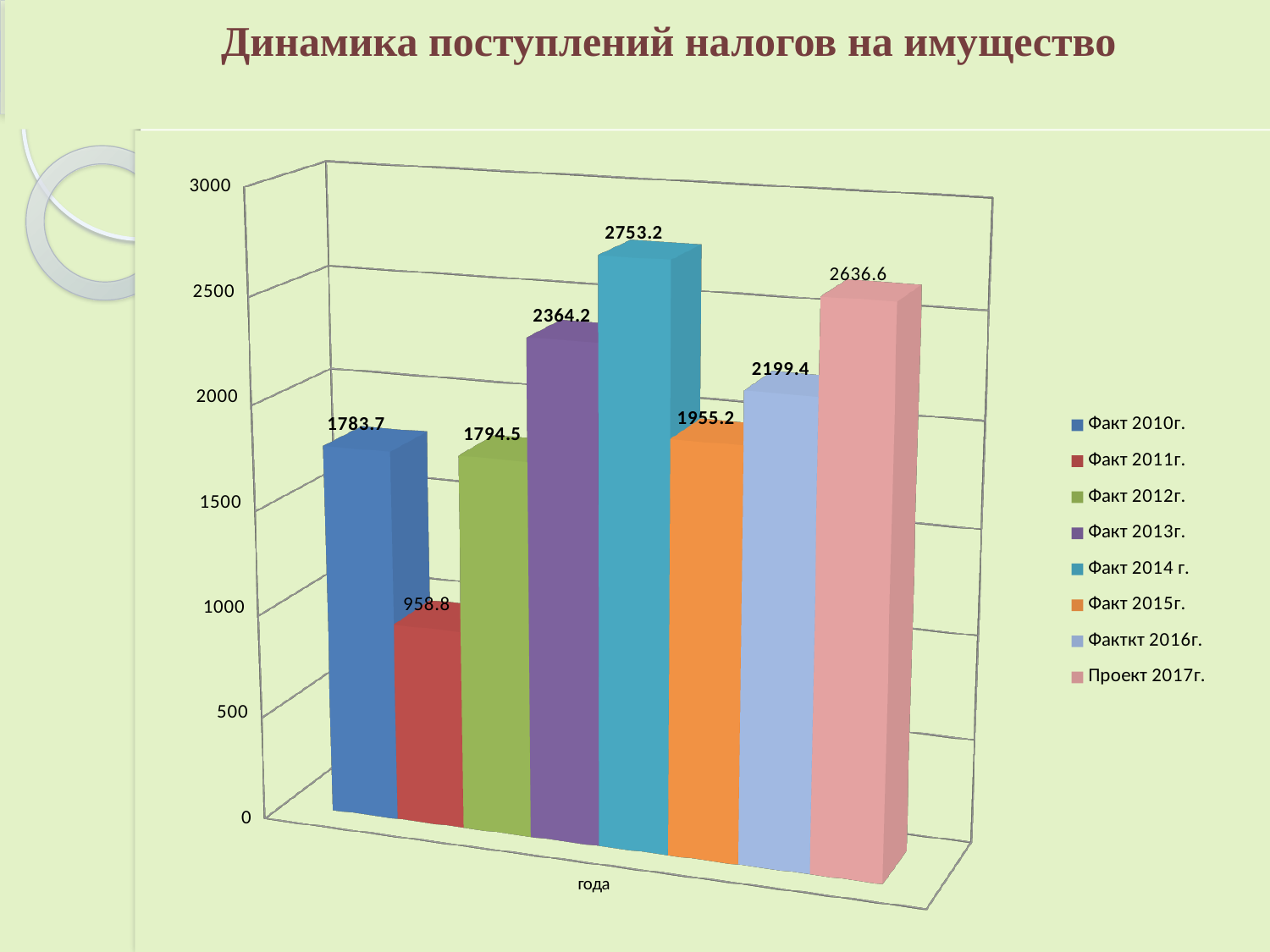
What is the title of the chart? Динамика поступлений налогов на имущество What is the difference between the values for Факт 2014 г. and Факт 2013г.? 389.0 What is the value for Факт 2014 г.? 2753.2 What kind of chart is shown on the slide? bar chart Which is larger, the value for Факткт 2016г. or the value for Факт 2015г.? Факткт 2016г. Which series has the lowest value? Факт 2011г. What is the value for Факт 2015г.? 1955.2 Is the value for Факт 2013г. greater or less than 2000? greater How many series does the legend list? 8 What is the value for Факт 2011г.? 958.8 What is the value for Проект 2017г.? 2636.6 Which series has the highest value? Факт 2014 г.